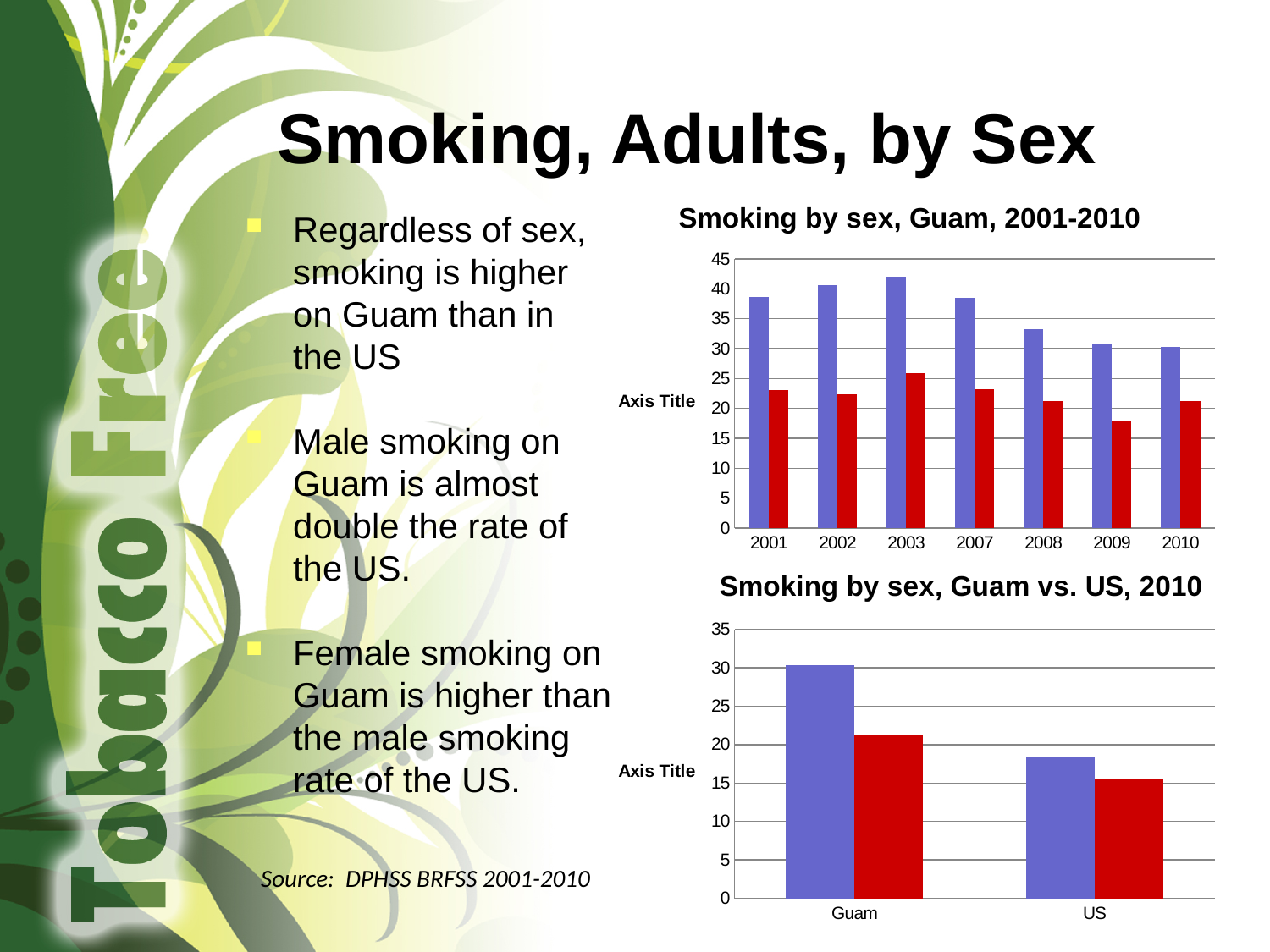
In the chart titled 'Smoking by sex, Guam vs. US, 2010', how many categories are shown on the x axis? 2 In the chart titled 'Smoking by sex, Guam, 2001-2010', in which year is the red bar lowest? 2009 In the chart titled 'Smoking by sex, Guam vs. US, 2010', is the blue bar for Guam greater or less than 25? greater In the chart titled 'Smoking by sex, Guam, 2001-2010', how many years are shown on the x axis? 7 What is the title of the lower chart on the slide? Smoking by sex, Guam vs. US, 2010 In the chart titled 'Smoking by sex, Guam, 2001-2010', what kind of chart is shown? bar chart In the chart titled 'Smoking by sex, Guam, 2001-2010', is the red bar for 2009 greater or less than 20? less In the chart titled 'Smoking by sex, Guam, 2001-2010', which year has the larger blue bar, 2003 or 2010? 2003 In the chart titled 'Smoking by sex, Guam, 2001-2010', is the blue bar for 2003 greater or less than 40? greater In the chart titled 'Smoking by sex, Guam, 2001-2010', do the blue bars rise or fall from 2007 to 2010? fall In the chart titled 'Smoking by sex, Guam, 2001-2010', in which year is the blue bar highest? 2003 In the chart titled 'Smoking by sex, Guam vs. US, 2010', which category has the taller blue bar, Guam or US? Guam